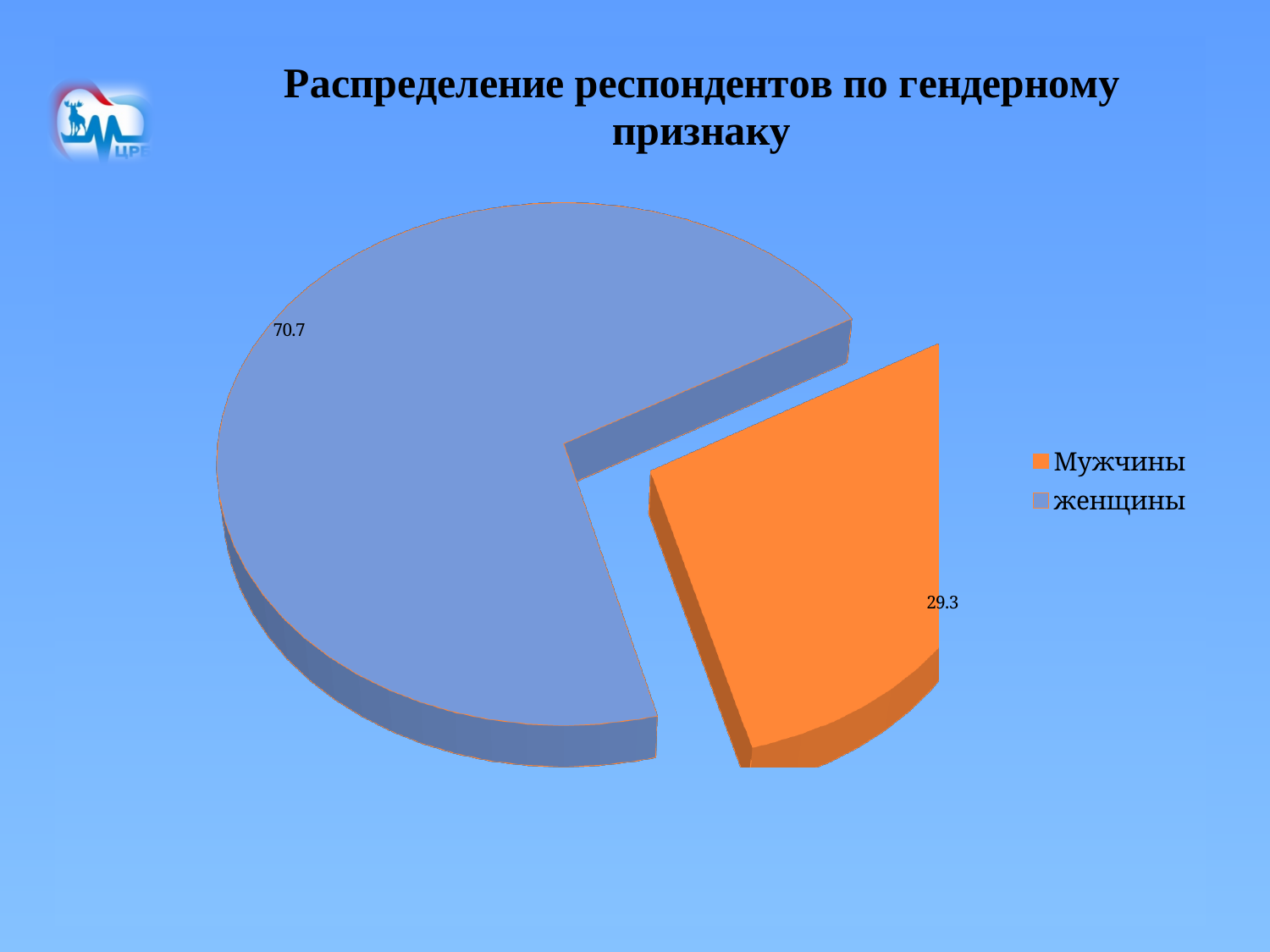
Which is larger, the value for Мужчины or the value for женщины? женщины What is the value for женщины? 70.7 Which category has the largest slice? женщины What is the total of the two slice values? 100 How many slices does the pie chart have? 2 Which category has the smallest slice? Мужчины What is the value for Мужчины? 29.3 What is the title of the chart? Распределение респондентов по гендерному признаку What kind of chart is shown on the slide? pie chart How many entries does the legend list? 2 What is the difference between the values for женщины and Мужчины? 41.4 What colour is the slice for Мужчины? orange